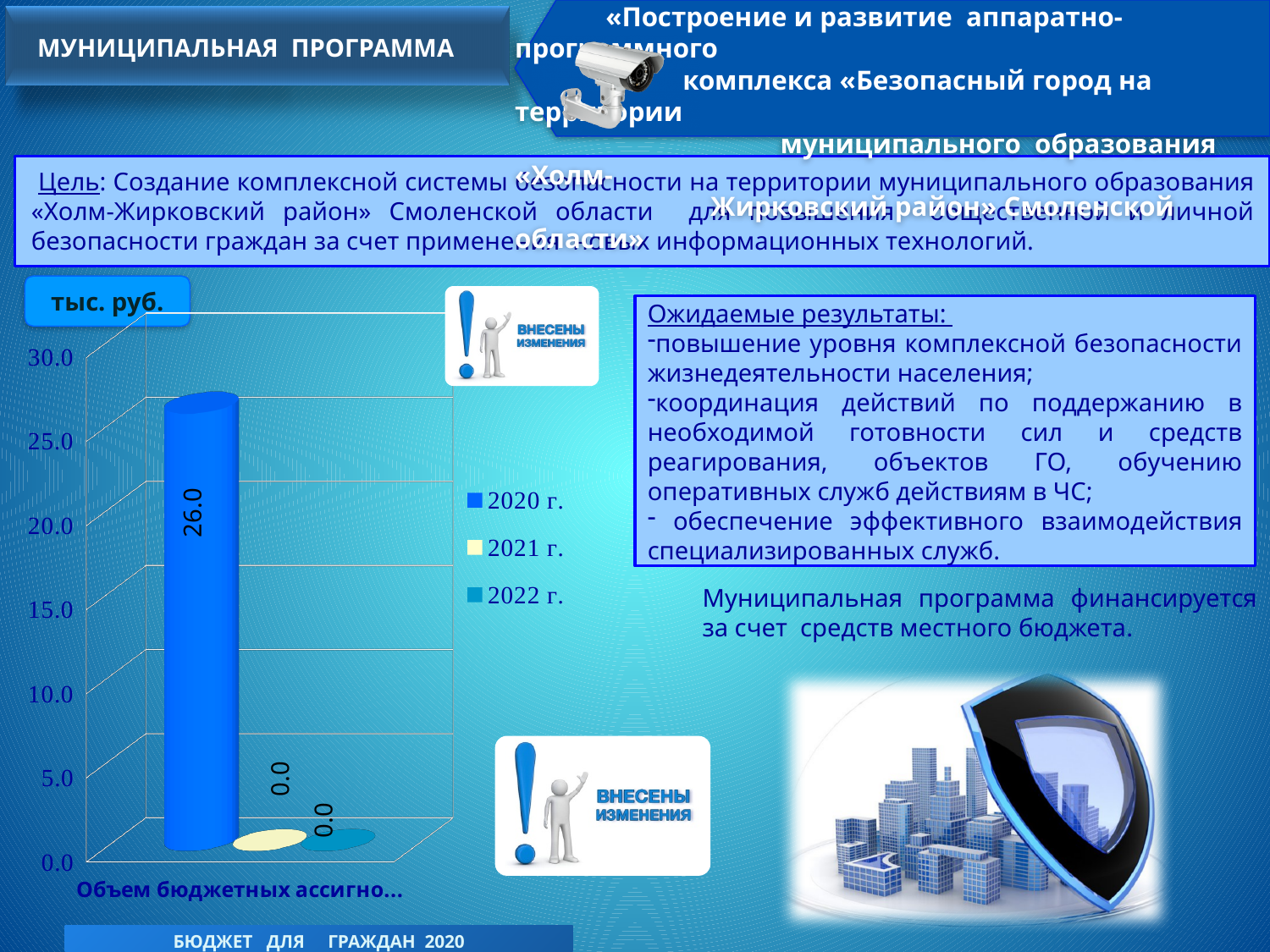
Is the value for 2020 г. greater or less than 25.0? greater Is the value for 2020 г. greater or less than 30.0? less What is the highest value shown on the chart's vertical axis? 30.0 What is the difference between the values for 2020 г. and 2021 г.? 26.0 What kind of chart is shown on the slide? bar chart Which is larger, the value for 2020 г. or the value for 2022 г.? 2020 г. What is the value for 2021 г. in the chart? 0.0 Which year has the highest value in the chart? 2020 г. How many series does the chart legend list? 3 What is the value for 2022 г. in the chart? 0.0 What unit is shown in the label above the chart? тыс. руб. What is the value for 2020 г. in the chart? 26.0